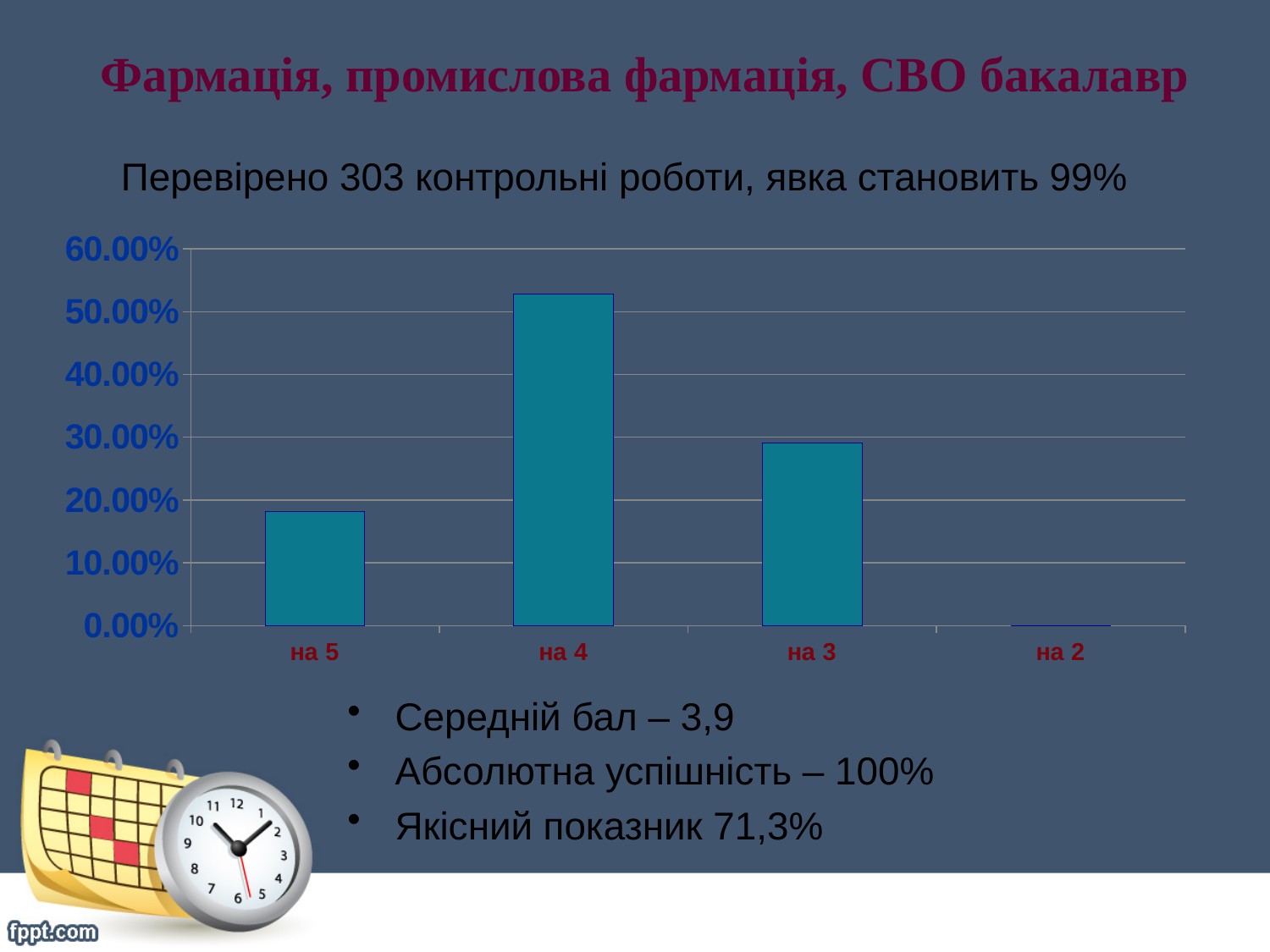
How many categories are shown on the x axis of the chart? 4 Is the value for на 4 greater or less than 50.00%? greater What kind of chart is shown on the slide? bar chart Is the value for на 5 greater or less than 10.00%? greater Which is larger, the value for на 3 or the value for на 5? на 3 Which category has the highest bar in the chart? на 4 Which category has the lowest value in the chart? на 2 What is the label of the first category on the x axis of the chart? на 5 Which is larger, the value for на 4 or the value for на 3? на 4 Is the value for на 3 greater or less than 20.00%? greater What is the highest value shown on the vertical axis of the chart? 60.00%